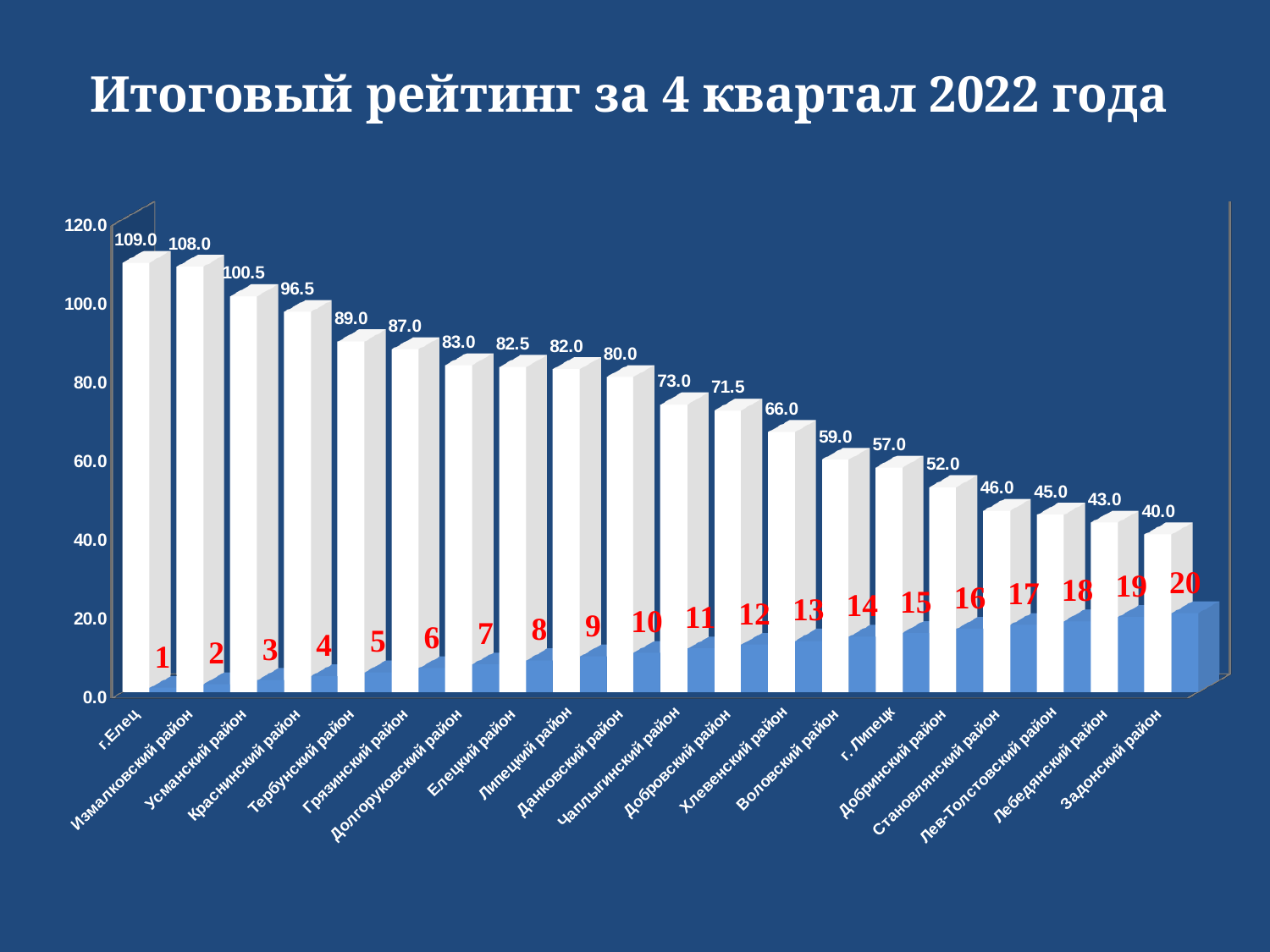
How many categories are shown on the chart? 20 What is the value for г. Липецк? 57.0 What is the value for Хлевенский район? 66.0 Which category has the highest value? г.Елец Which category has the lowest value? Задонский район Which is larger, the value for Данковский район or the value for Добринский район? Данковский район Is the value for Воловский район greater or less than 60.0? less What kind of chart is shown on the slide? bar chart What is the value for Усманский район? 100.5 What is the title of the chart? Итоговый рейтинг за 4 квартал 2022 года What is the difference between the values for Тербунский район and Грязинский район? 2.0 What is the difference between the values for г.Елец and Задонский район? 69.0